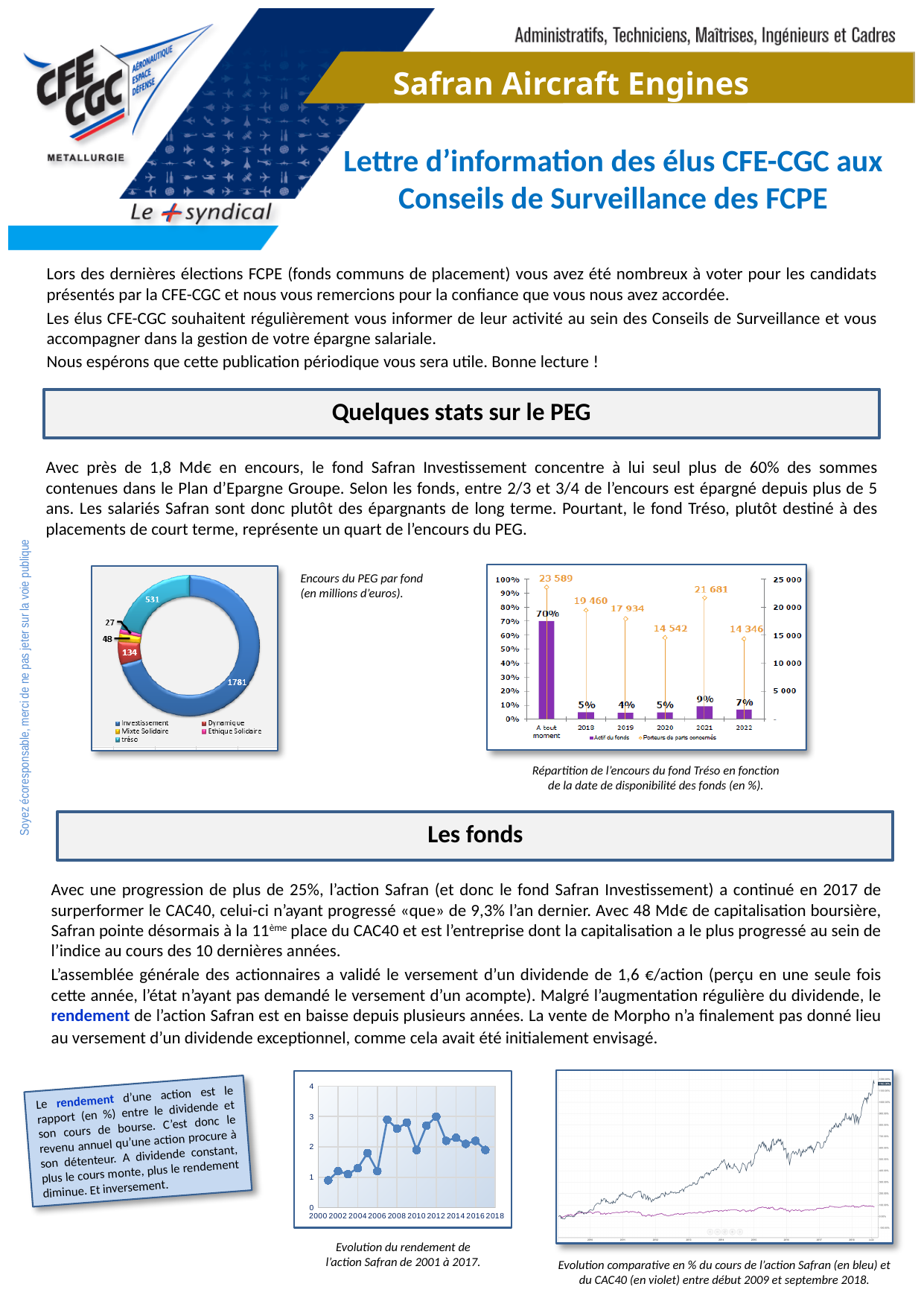
In the chart 'Répartition de l'encours du fond Tréso', what percentage of the fund's assets is available 'A tout moment'? 70% In the chart 'Répartition de l'encours du fond Tréso', which year from 2018 to 2022 has the lowest 'Actif du fonds' percentage? 2019 How many funds are listed in the legend of the donut chart 'Encours du PEG par fond'? 5 In the donut chart 'Encours du PEG par fond', what is the difference between the Investissement value and the tréso value? 1250 In the chart 'Evolution du rendement de l'action Safran', is the value for 2017 greater or less than 3? less In the donut chart 'Encours du PEG par fond', what is the value for tréso? 531 In the chart 'Répartition de l'encours du fond Tréso', which has more 'Porteurs de parts concernés', 2021 or 2022? 2021 How many series does the legend of the chart 'Répartition de l'encours du fond Tréso' list? 2 In the chart 'Répartition de l'encours du fond Tréso', what is the 'Actif du fonds' value for 2021? 9% In the donut chart 'Encours du PEG par fond', what is the value for Investissement? 1781 In the chart 'Répartition de l'encours du fond Tréso', how many 'Porteurs de parts concernés' are there for 2018? 19 460 In the donut chart 'Encours du PEG par fond', which fund has the largest encours? Investissement